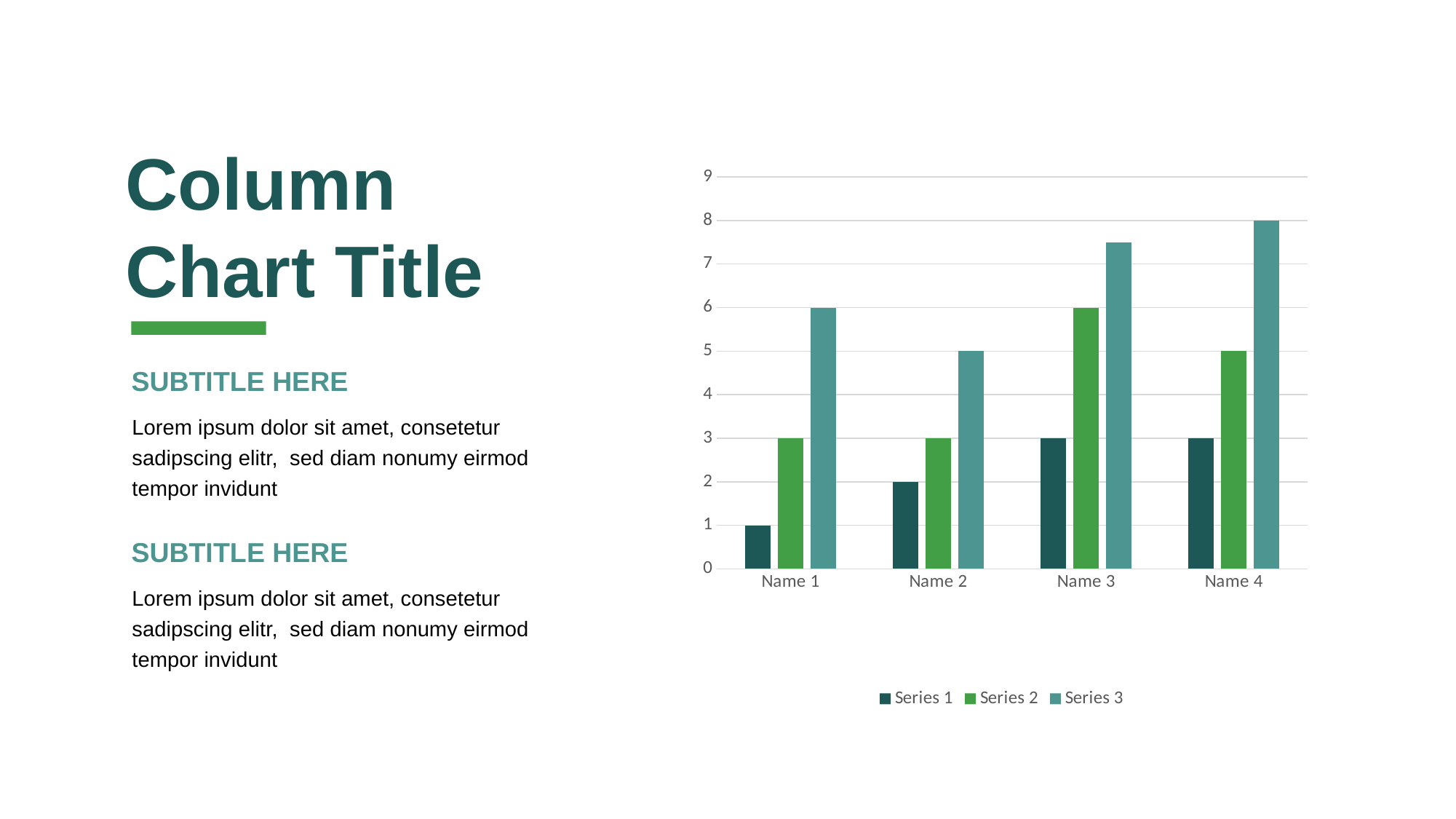
Do the Series 1 values generally rise or fall from Name 1 to Name 4? rise Which category has the highest Series 3 value? Name 4 Which is larger for Name 2: Series 2 or Series 3? Series 3 How many series does the legend list? 3 What is the difference between the Series 3 and Series 1 values for Name 4? 5 Which category has the lowest Series 1 value? Name 1 What kind of chart is shown on the slide? bar chart What is the value of Series 3 for Name 4? 8 Is the Series 3 value for Name 3 greater or less than 7? greater How many categories are shown on the x axis? 4 What is the value of Series 1 for Name 1? 1 What is the value of Series 2 for Name 3? 6